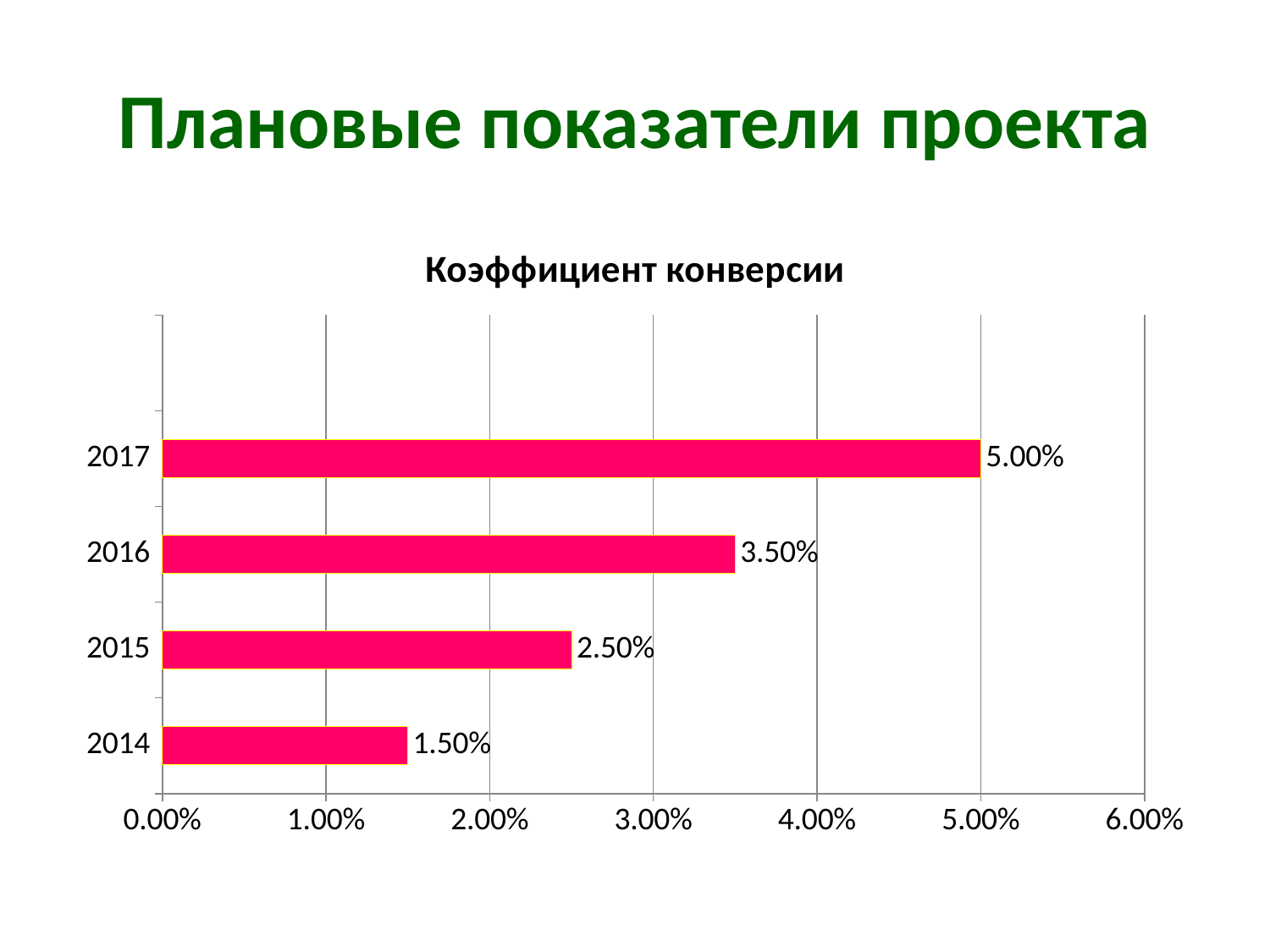
Which year has the highest conversion rate? 2017 What is the value shown for 2016? 3.50% Which is larger, the value for 2015 or the value for 2016? 2016 How many years are shown in the chart? 4 What kind of chart is shown on the slide? bar chart What is the conversion rate value for 2017? 5.00% Is the value for 2016 greater or less than 3.00%? greater What is the conversion rate value for 2014? 1.50% What is the difference between the values for 2017 and 2015? 2.50% What is the title of the chart? Коэффициент конверсии Which year has the lowest conversion rate? 2014 What is the difference between the values for 2016 and 2014? 2.00%